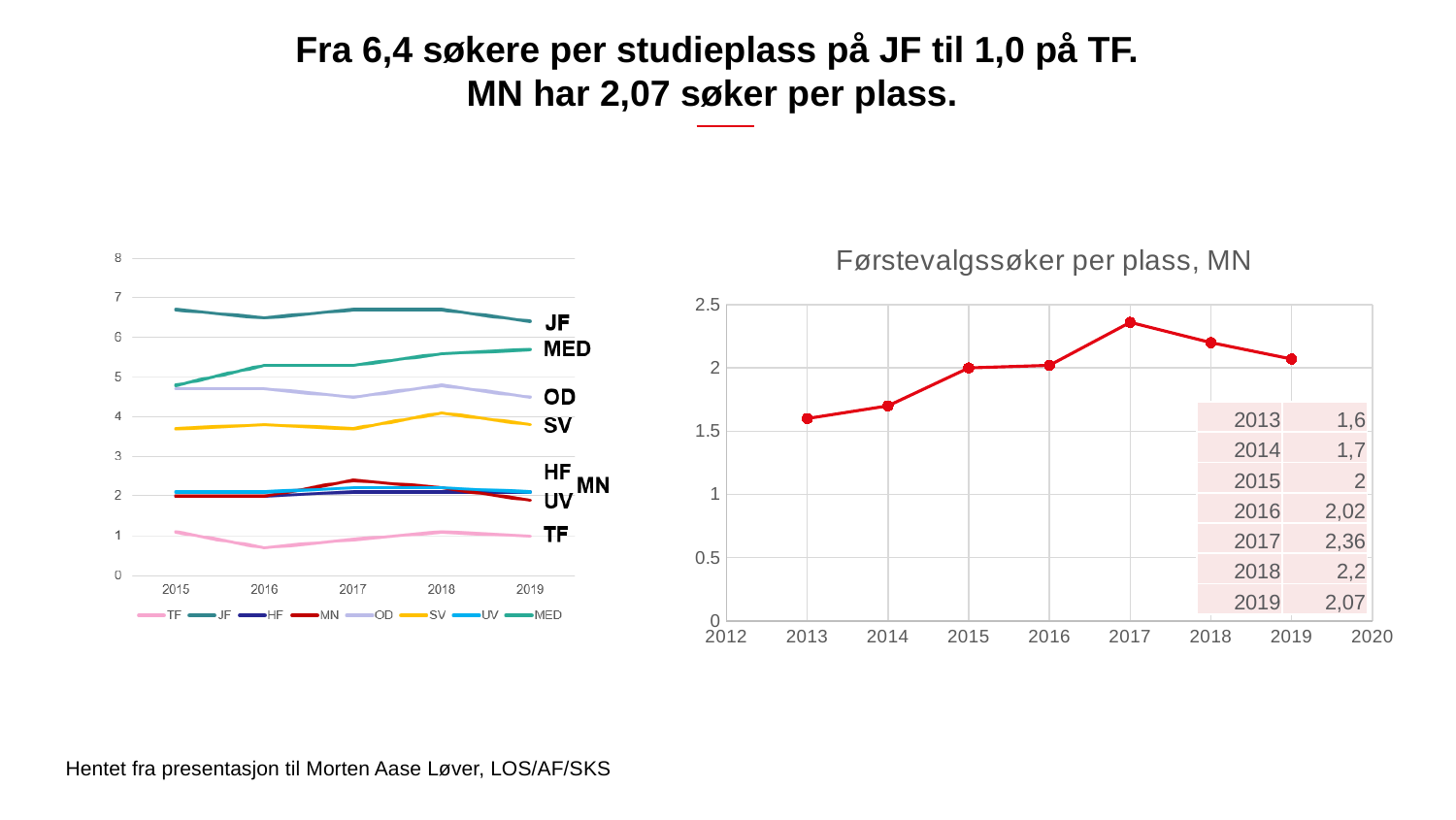
In the left chart, is the value for TF in 2016 greater or less than 1? less In the chart titled 'Førstevalgssøker per plass, MN', what is the difference between the 2017 value and the 2019 value? 0,29 How many series does the legend of the left chart list? 8 In the left chart, which series has the highest values across all years? JF In the chart titled 'Førstevalgssøker per plass, MN', is the value for 2018 larger than the value for 2016? Yes In the chart titled 'Førstevalgssøker per plass, MN', how many data points are plotted? 7 In the chart titled 'Førstevalgssøker per plass, MN', which year has the highest value? 2017 What kind of chart is the chart on the left of the slide? Line chart In the chart titled 'Førstevalgssøker per plass, MN', what is the value for 2013? 1,6 In the chart titled 'Førstevalgssøker per plass, MN', which year has the lowest value? 2013 In the left chart, is the value for JF in 2019 greater or less than 6? greater In the chart titled 'Førstevalgssøker per plass, MN', what is the value for 2017? 2,36